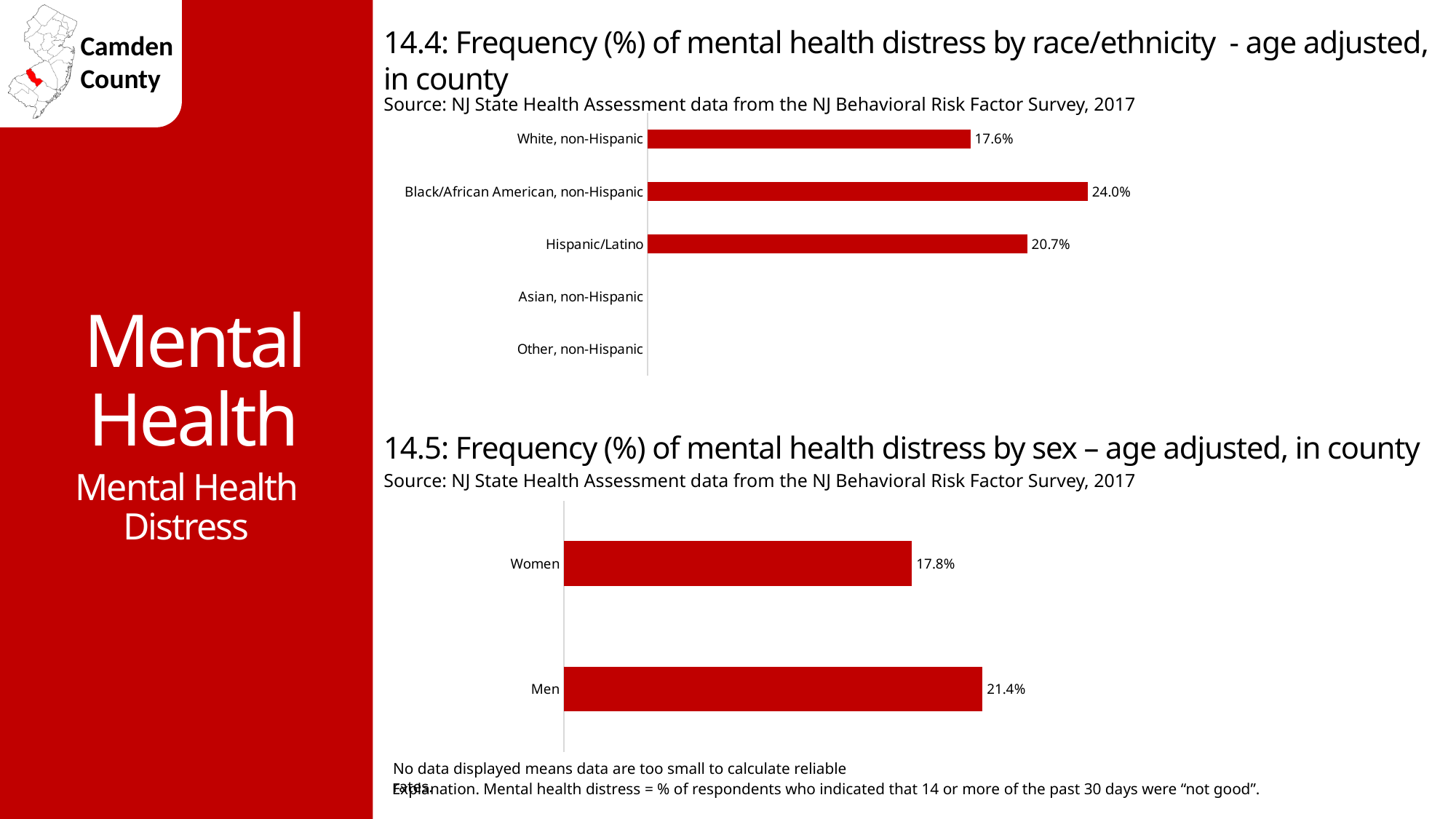
In chart 14.4 (mental health distress by race/ethnicity), what is the value for Hispanic/Latino? 20.7% In chart 14.5 (mental health distress by sex), which group has the higher value, Women or Men? Men In chart 14.4 (mental health distress by race/ethnicity), what is the value for Black/African American, non-Hispanic? 24.0% In chart 14.4 (mental health distress by race/ethnicity), how many race/ethnicity categories are listed on the axis? 5 In chart 14.5 (mental health distress by sex), what is the value for Women? 17.8% What kind of chart is chart 14.5 (mental health distress by sex)? Bar chart In chart 14.4 (mental health distress by race/ethnicity), what is the difference between the Black/African American, non-Hispanic and White, non-Hispanic values? 6.4% In chart 14.4 (mental health distress by race/ethnicity), which race/ethnicity group has the highest value? Black/African American, non-Hispanic In chart 14.5 (mental health distress by sex), what is the value for Men? 21.4% In chart 14.4 (mental health distress by race/ethnicity), which categories have no bar displayed? Asian, non-Hispanic and Other, non-Hispanic In chart 14.4 (mental health distress by race/ethnicity), what is the value for White, non-Hispanic? 17.6% In chart 14.5 (mental health distress by sex), what is the difference between the Men and Women values? 3.6%